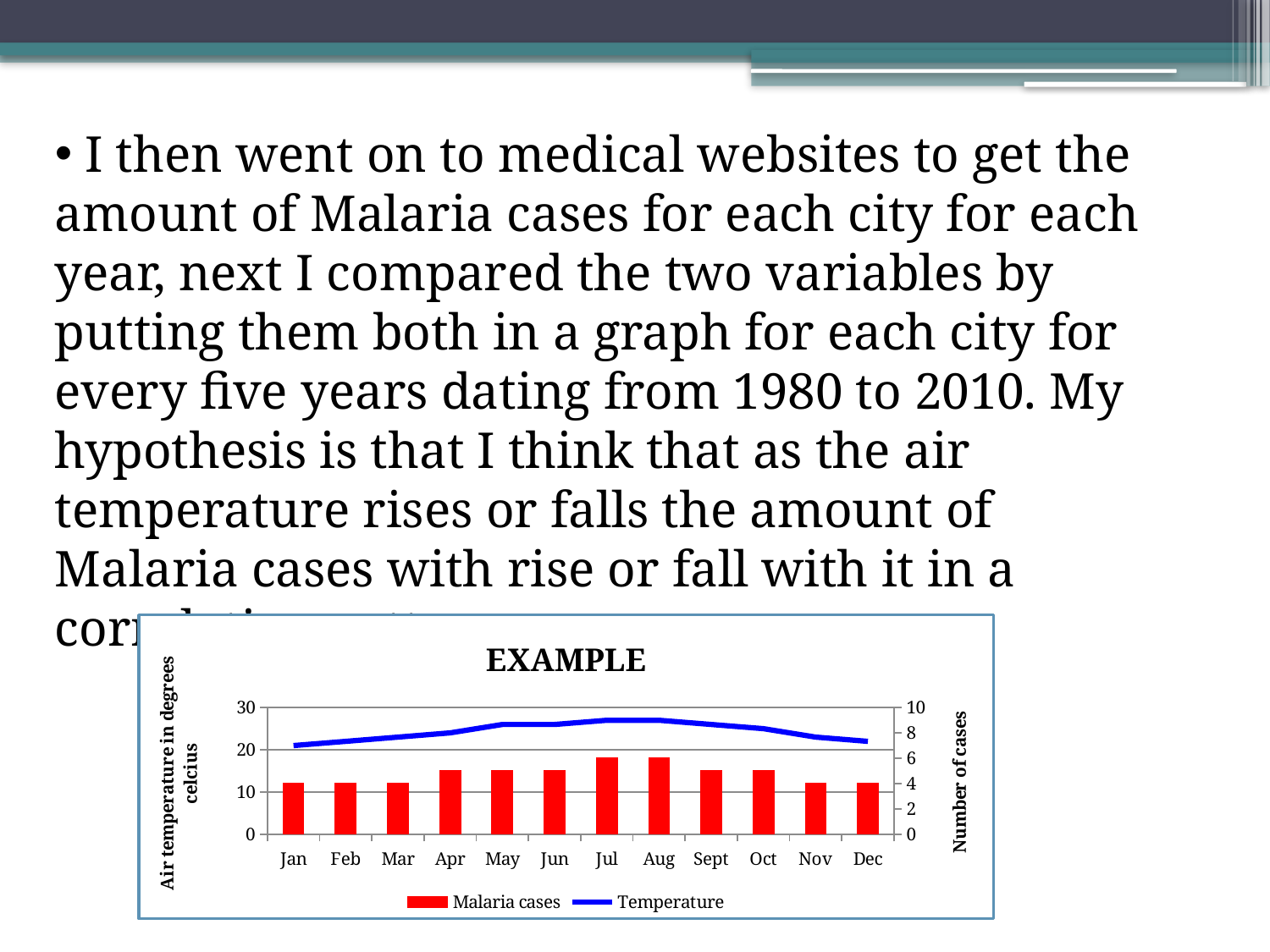
Which month has more Malaria cases, Jan or Jul? Jul Does the Temperature line rise or fall from Jan to Jul? rise Is the Temperature value for Jul greater or less than 20? greater How many months are shown on the x axis of the chart? 12 Which series is drawn as a line in the chart? Temperature Is the Malaria cases value for Jan greater or less than 6 on the Number of cases axis? less What kind of chart is shown on the slide? Combined bar and line chart How many series does the chart legend list? 2 Which month has a higher Temperature, Feb or Aug? Aug What is the title of the chart? EXAMPLE Is the Temperature value for Jan greater or less than 30? less